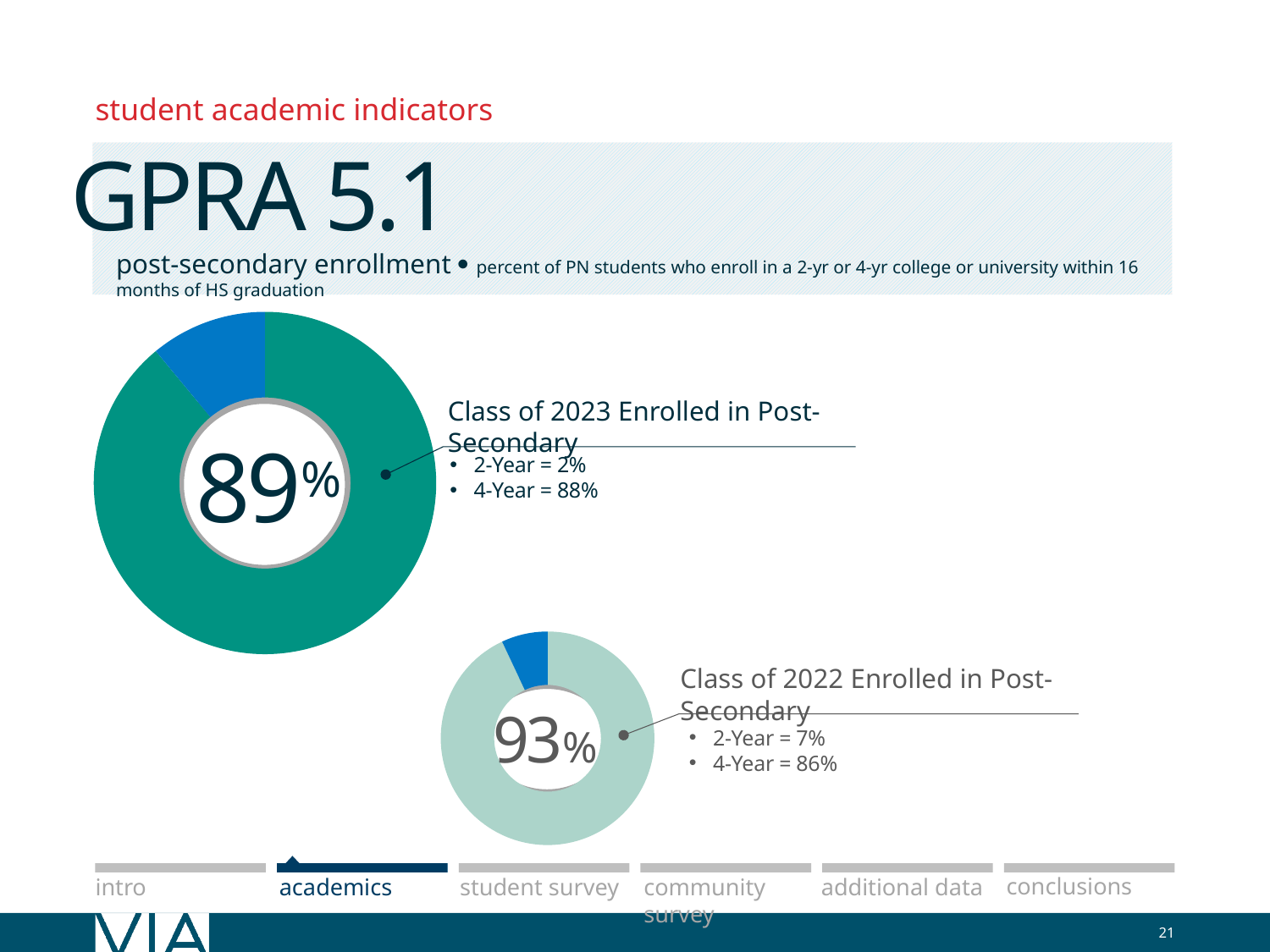
In the Class of 2023 Enrolled in Post-Secondary chart, what is the value for 2-Year enrollment? 2% In the Class of 2022 Enrolled in Post-Secondary chart, what is the difference between the 4-Year and 2-Year values? 79% What kind of chart is used to show the Class of 2023 post-secondary enrollment? Donut chart Which class has the higher overall post-secondary enrollment percentage shown in the center of its donut, Class of 2023 or Class of 2022? Class of 2022 In the Class of 2022 Enrolled in Post-Secondary chart, what percentage is shown in the center of the donut? 93% In the Class of 2022 Enrolled in Post-Secondary chart, which category is larger, 2-Year or 4-Year? 4-Year In the Class of 2023 Enrolled in Post-Secondary chart, what percentage is shown in the center of the donut? 89% In the Class of 2023 Enrolled in Post-Secondary chart, what is the value for 4-Year enrollment? 88% How many categories are listed for the Class of 2023 Enrolled in Post-Secondary chart? 2 In the Class of 2023 Enrolled in Post-Secondary chart, which category is the smallest? 2-Year In the Class of 2022 Enrolled in Post-Secondary chart, what is the value for 2-Year enrollment? 7% In the Class of 2022 Enrolled in Post-Secondary chart, what is the value for 4-Year enrollment? 86%